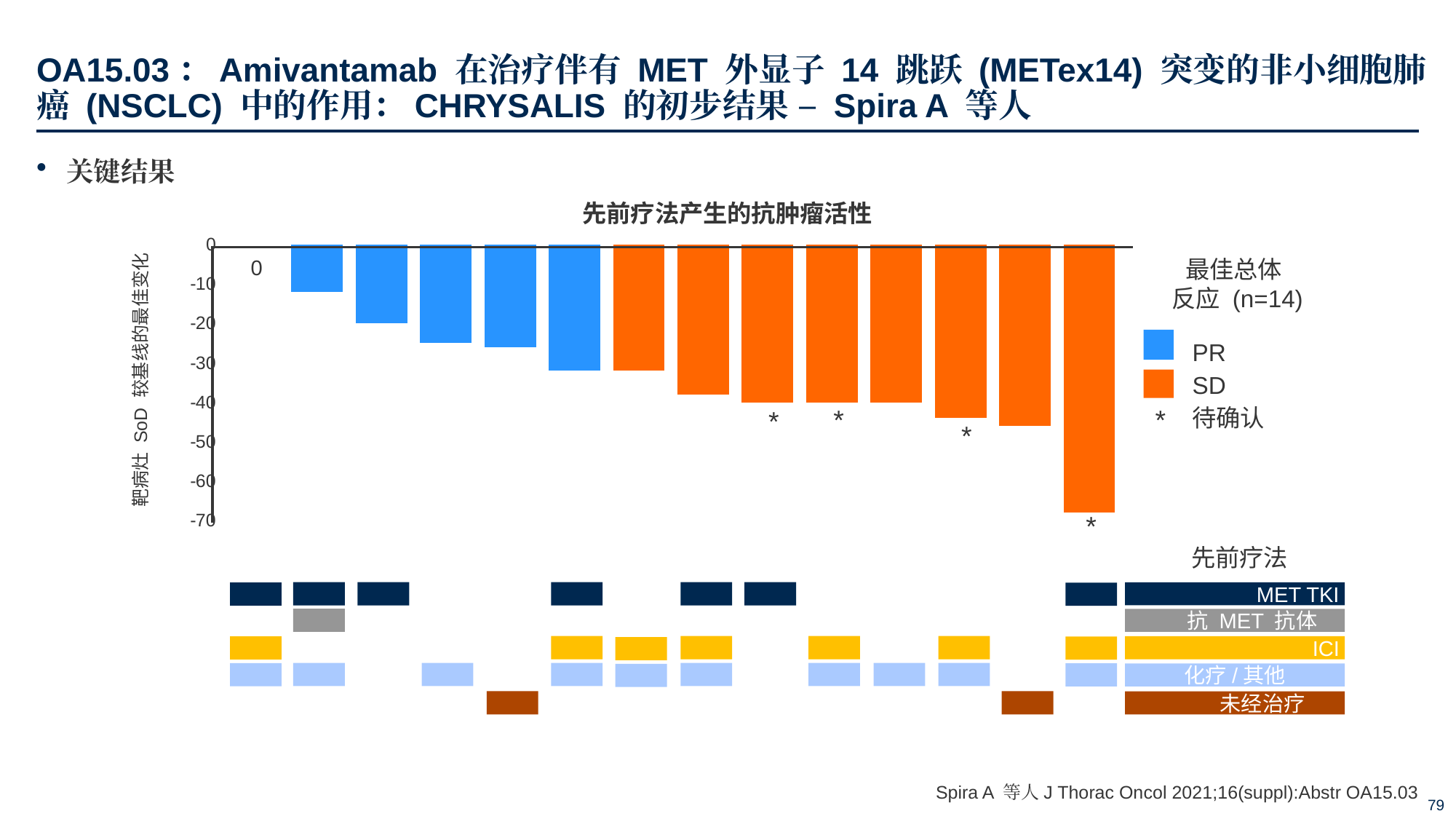
What is the value printed for the leftmost bar? 0 What kind of chart is shown on the slide? bar chart Which colour represents SD in the legend? orange How many bars are marked with an asterisk (待确认)? 4 Which bar shows the largest decrease from baseline? the rightmost bar What is the title of the chart? 先前疗法产生的抗肿瘤活性 Do the bar values rise or fall moving from left to right along the x axis? fall How many patients (bars) are plotted in the chart? 14 How many prior therapy categories are listed below the chart? 5 How many series does the legend list for best overall response? 2 Is the value for the rightmost bar greater or less than -60? less Is the value for the first blue (PR) bar greater or less than -20? greater